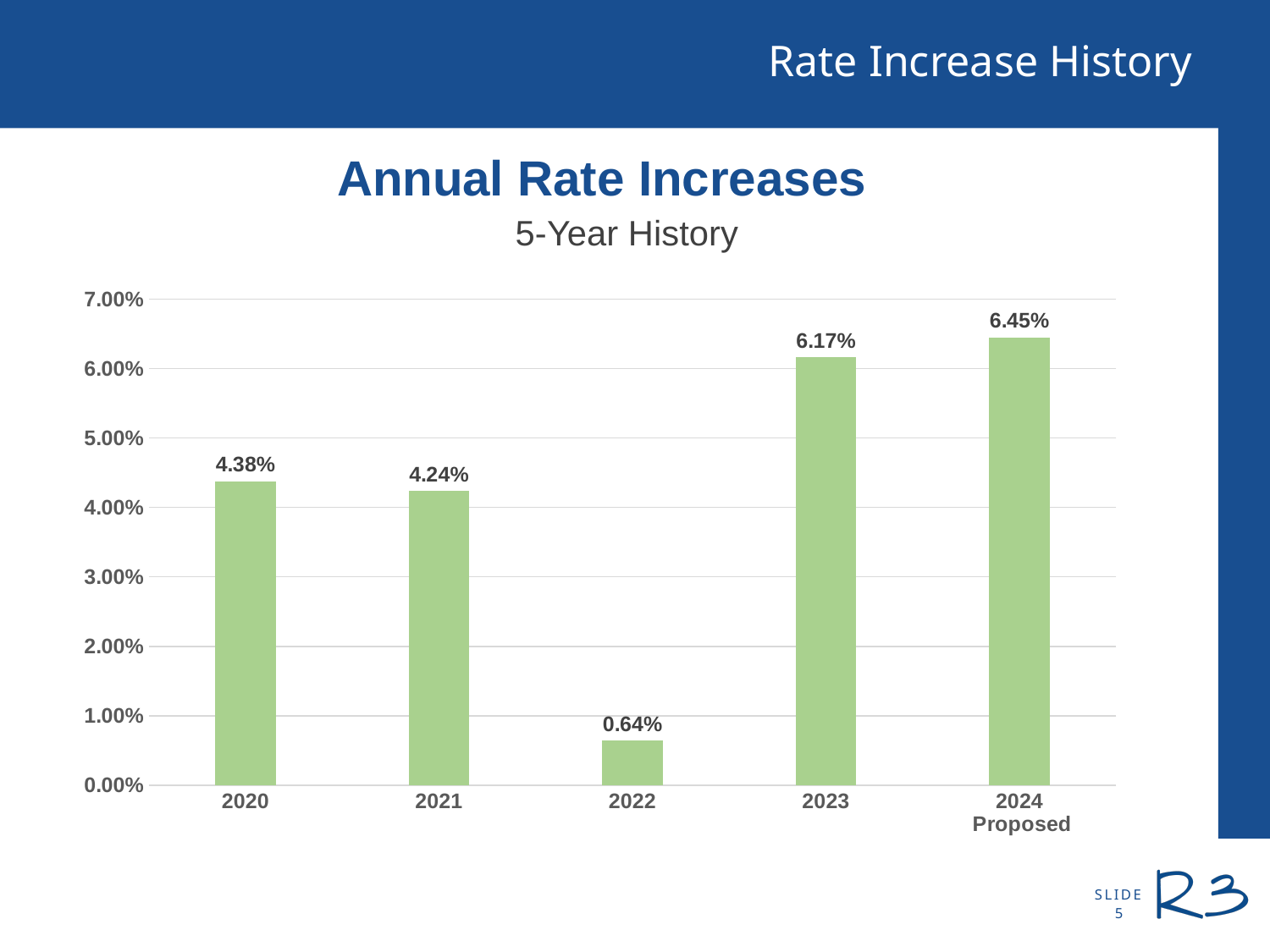
Which is larger, the rate increase for 2021 or for 2023? 2023 Which year has the highest rate increase on the chart? 2024 Proposed What is the annual rate increase shown for 2022? 0.64% What is the proposed rate increase for 2024? 6.45% Is the value for 2023 greater or less than 6.00%? greater Which year has the lowest rate increase on the chart? 2022 How many years are shown on the chart? 5 What is the title of the chart? Annual Rate Increases What is the annual rate increase shown for 2020? 4.38% What is the difference between the 2020 and 2021 rate increases? 0.14% What is the difference between the 2023 rate increase and the 2022 rate increase? 5.53% What kind of chart is shown on the slide? Bar chart